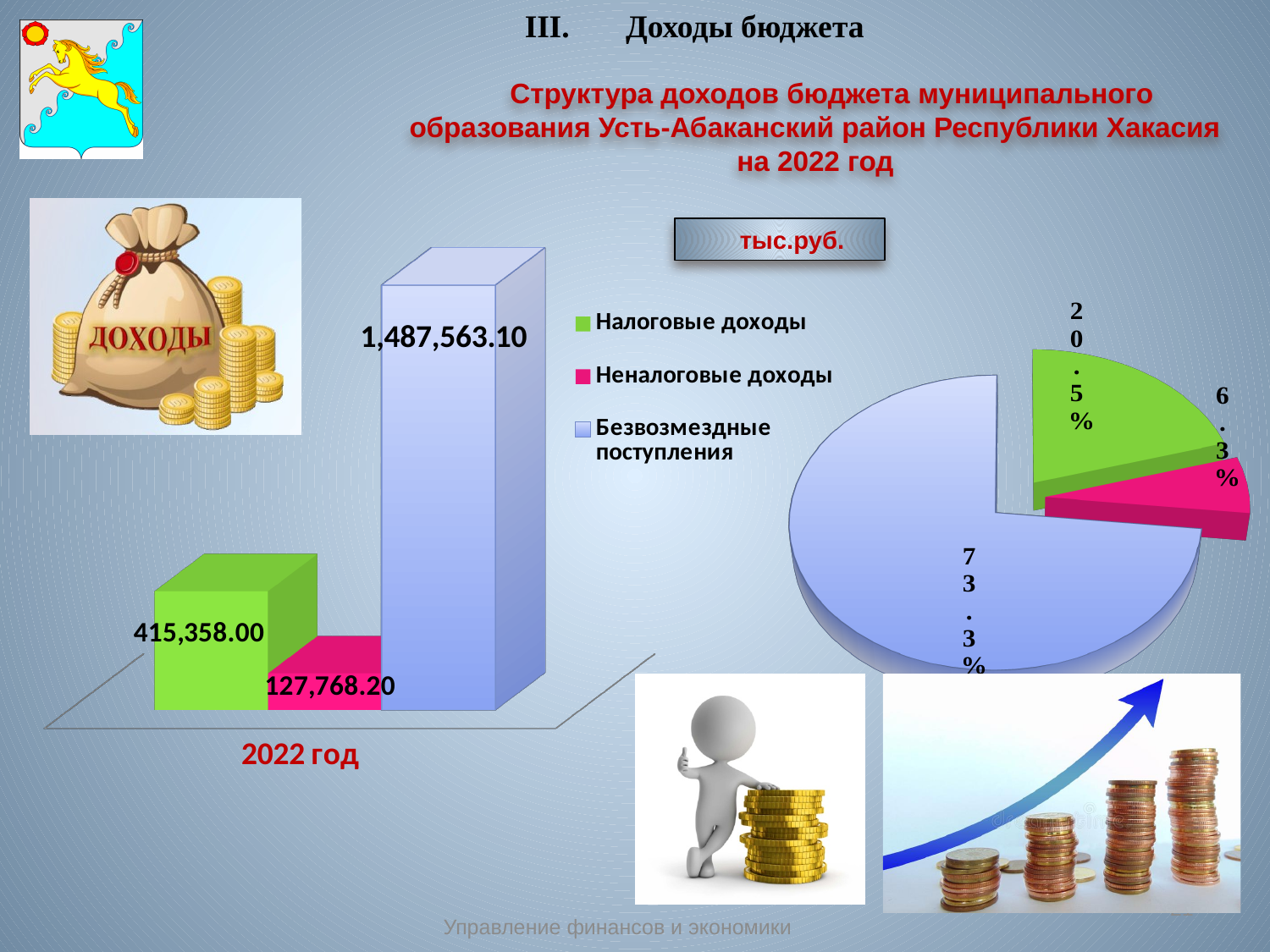
On the bar chart, what is the difference between Безвозмездные поступления and Налоговые доходы? 1,072,205.10 On the pie chart, what share does the Безвозмездные поступления slice have? 73.3% On the bar chart, which series has the lowest value? Неналоговые доходы On the pie chart, what share does the Налоговые доходы slice have? 20.5% On the bar chart, what is the difference between Налоговые доходы and Неналоговые доходы? 287,589.80 On the bar chart, which series has the highest value? Безвозмездные поступления On the bar chart, what is the value for Налоговые доходы in 2022 год? 415,358.00 How many series does the legend list? 3 What kind of chart is on the left side of the slide? bar chart On the bar chart, which is larger: Налоговые доходы or Неналоговые доходы? Налоговые доходы On the bar chart, what is the value for Неналоговые доходы in 2022 год? 127,768.20 On the bar chart, what is the value for Безвозмездные поступления in 2022 год? 1,487,563.10